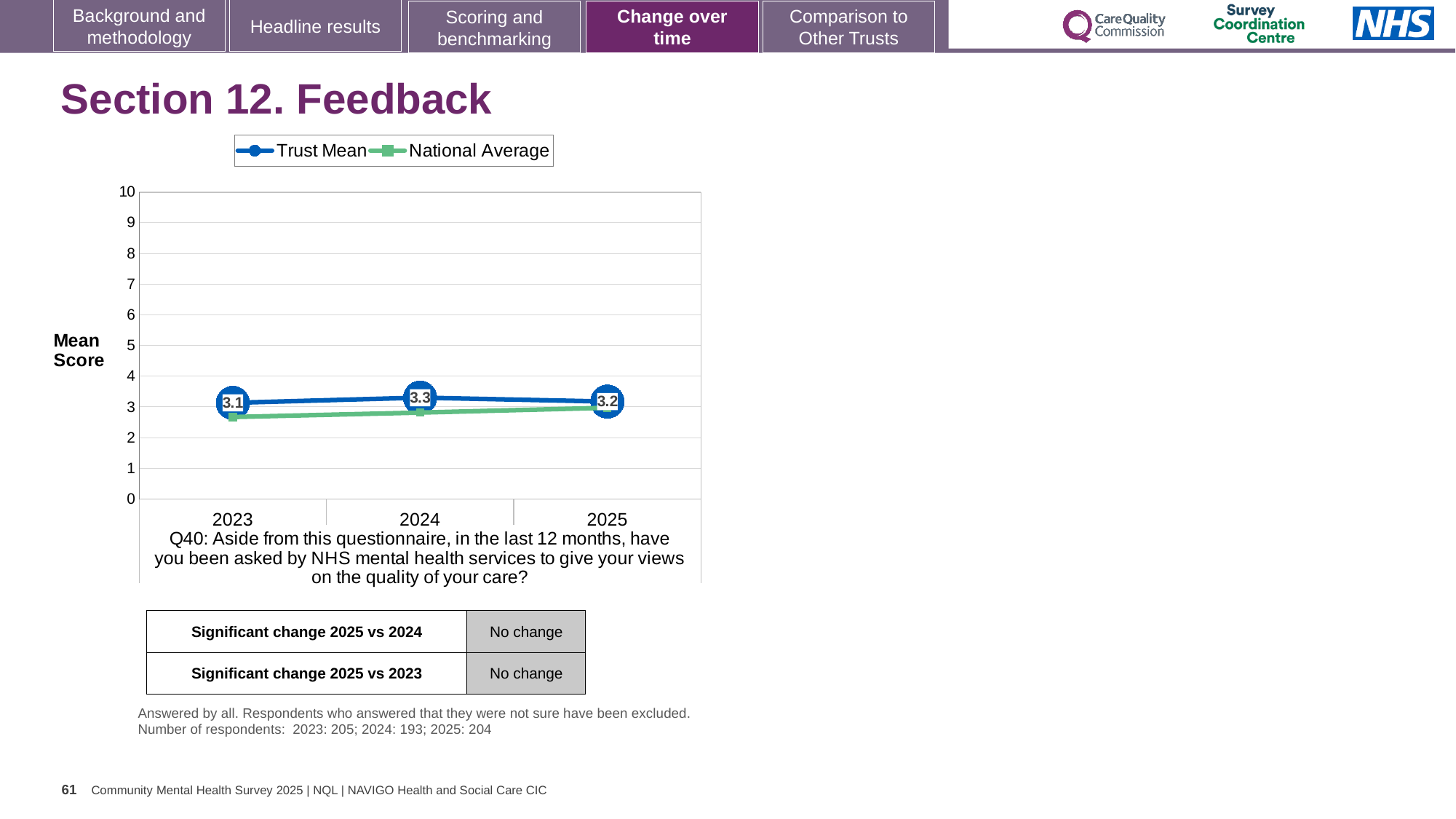
What is the Trust Mean value for 2023? 3.1 In which year is the Trust Mean highest? 2024 How many series does the legend list? 2 Is the National Average value for 2023 greater or less than 3? less How many years are shown on the x axis? 3 What is the difference between the Trust Mean in 2024 and in 2023? 0.2 What is the Trust Mean value for 2024? 3.3 Which is larger, the Trust Mean in 2024 or in 2025? 2024 What kind of chart is shown on the slide? line chart What is the Trust Mean value for 2025? 3.2 Does the Trust Mean rise or fall from 2023 to 2024? rise In which year is the Trust Mean lowest? 2023